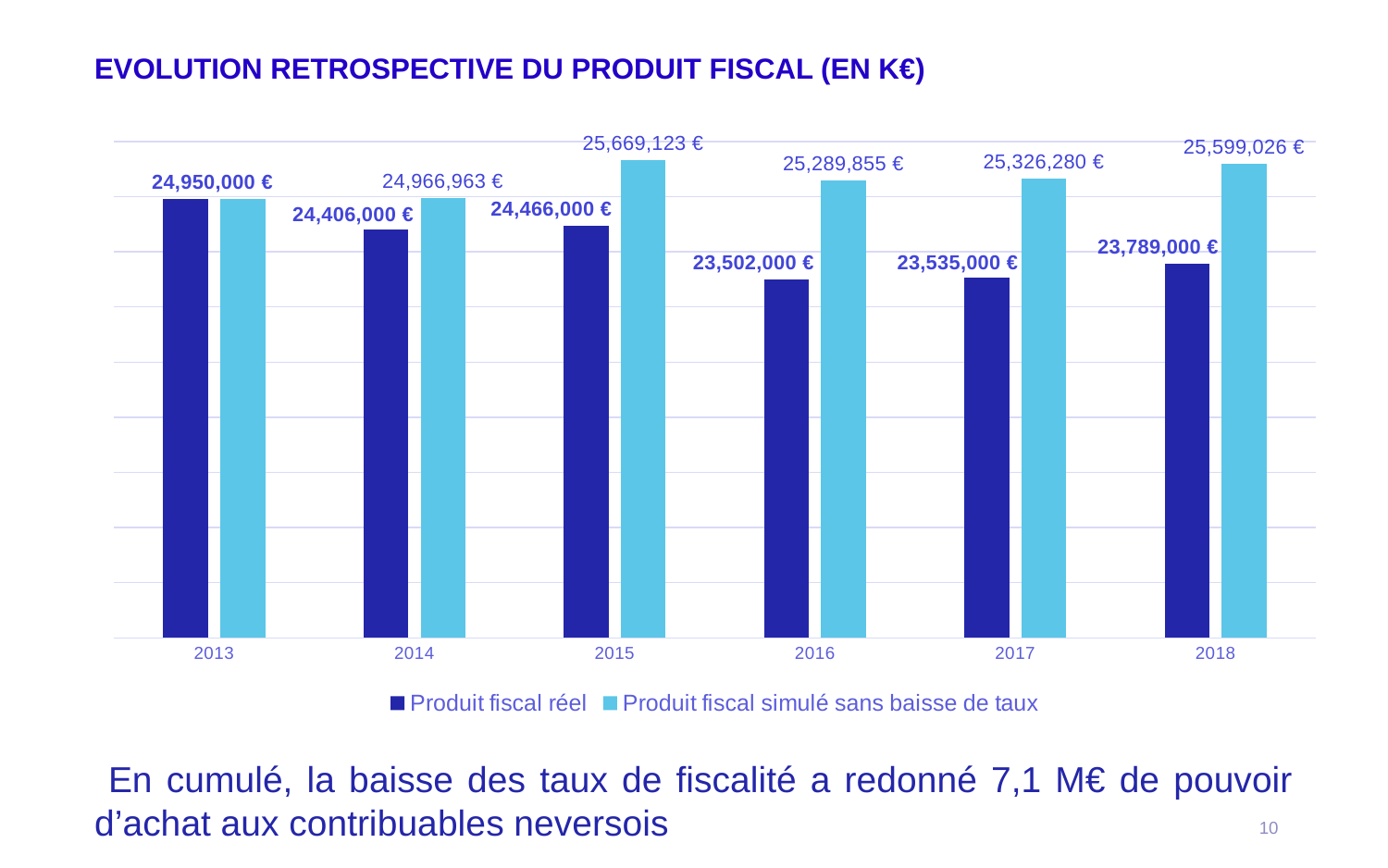
How many series does the legend list? 2 In which year is Produit fiscal réel the highest? 2013 What is the value of Produit fiscal réel for 2016? 23,502,000 € What is the difference between Produit fiscal simulé sans baisse de taux and Produit fiscal réel in 2018? 1,810,026 € In which year is Produit fiscal simulé sans baisse de taux the highest? 2015 What kind of chart is shown on the slide? Bar chart Does Produit fiscal réel rise or fall from 2015 to 2016? Fall What is the value of Produit fiscal simulé sans baisse de taux for 2015? 25,669,123 € What is the value of Produit fiscal réel for 2018? 23,789,000 € In which year is Produit fiscal réel the lowest? 2016 How many years are shown on the x axis of the chart? 6 Which is larger in 2017: Produit fiscal réel or Produit fiscal simulé sans baisse de taux? Produit fiscal simulé sans baisse de taux